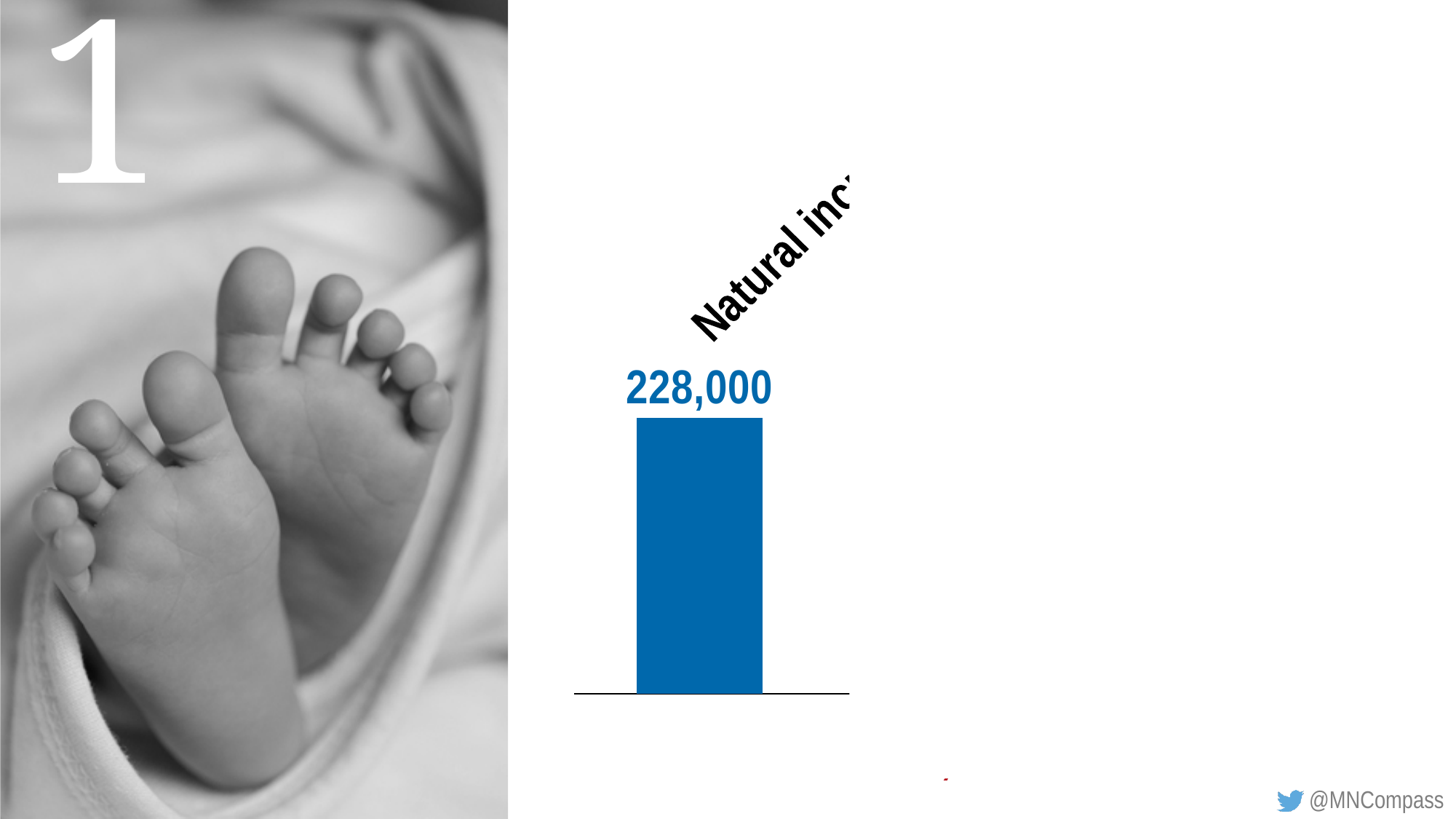
How many bars does the chart show? 1 What kind of chart is shown on the slide? bar chart What value is printed above the single bar in the chart? 228,000 Is the value shown on the bar greater or less than 200,000? greater What is the data label shown on the bar in the chart? 228,000 What colour is the bar in the chart? blue